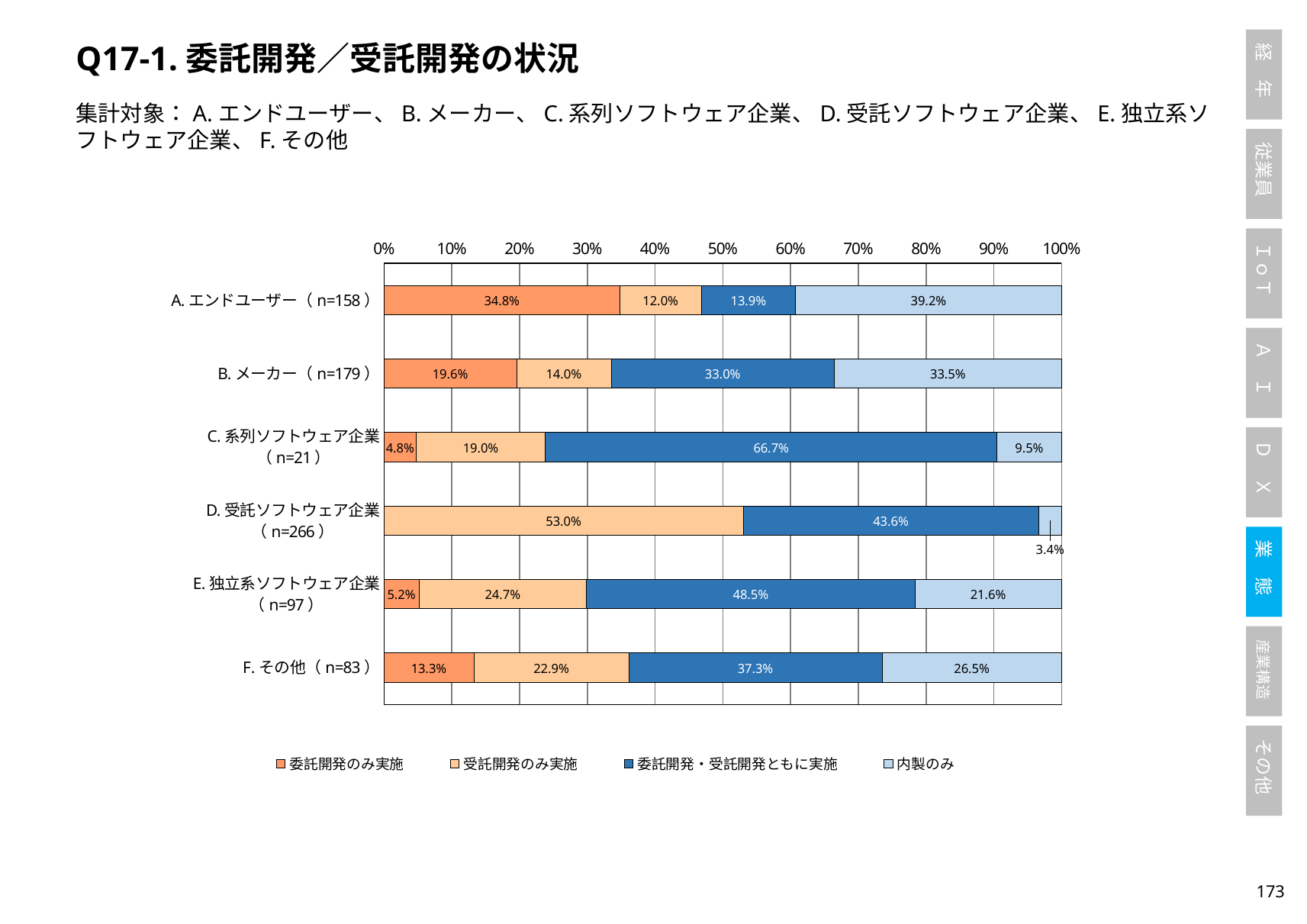
Which is larger: the 受託開発のみ実施 value for B. メーカー or for F. その他? F. その他 What is the value of 委託開発・受託開発ともに実施 for C. 系列ソフトウェア企業? 66.7% What is the difference between the 委託開発・受託開発ともに実施 values for E. 独立系ソフトウェア企業 and F. その他? 11.2% What is the sample size (n) for B. メーカー? 179 Which category has the lowest value for 内製のみ? D. 受託ソフトウェア企業 What is the value of 受託開発のみ実施 for D. 受託ソフトウェア企業? 53.0% How many series does the legend list? 4 What is the label of the darkest blue series in the legend? 委託開発・受託開発ともに実施 Which category has the highest value for 委託開発のみ実施? A. エンドユーザー What is the value of 内製のみ for A. エンドユーザー? 39.2% What type of chart is shown on the slide? Stacked bar chart How many categories (respondent groups) are plotted on the chart? 6